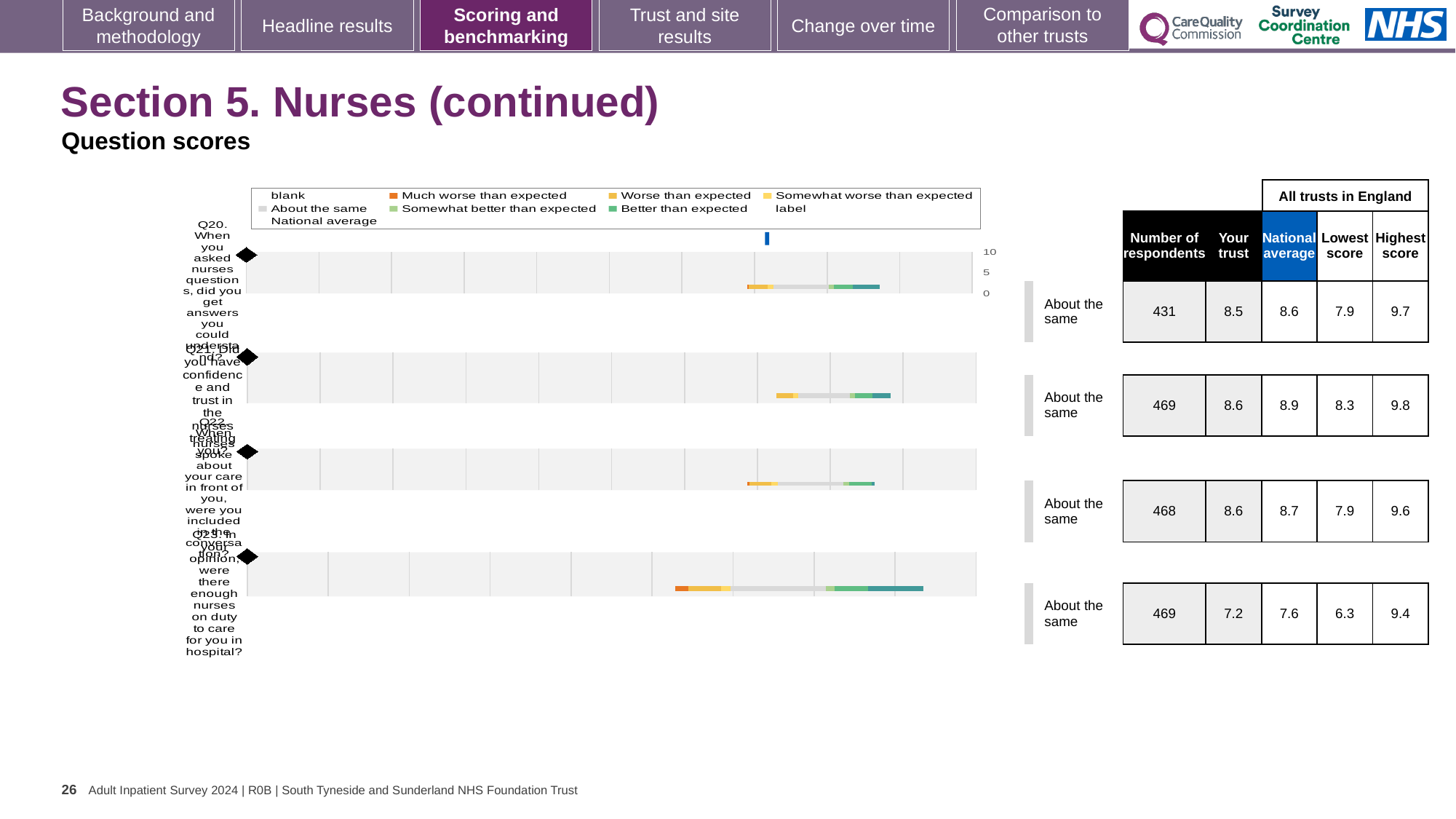
What is the difference between the highest score and the lowest score for Q20? 1.8 What kind of chart is used to show the question scores on this slide? bar chart Which question has the highest national average score? Q21 For Q20, which is larger: the 'Your trust' score or the national average? National average How many questions (bars) are shown in the chart? 4 What is the difference between the national average and the 'Your trust' score for Q23? 0.4 Is the 'Your trust' score for Q23 greater or less than 8? less What is the 'Your trust' score for Q23 (were there enough nurses on duty to care for you in hospital)? 7.2 Which question has the lowest 'Your trust' score? Q23 How many respondents answered Q20? 431 What benchmark category is shown for all four questions in the chart? About the same What is the national average score for Q21 (did you have confidence and trust in the nurses treating you)? 8.9